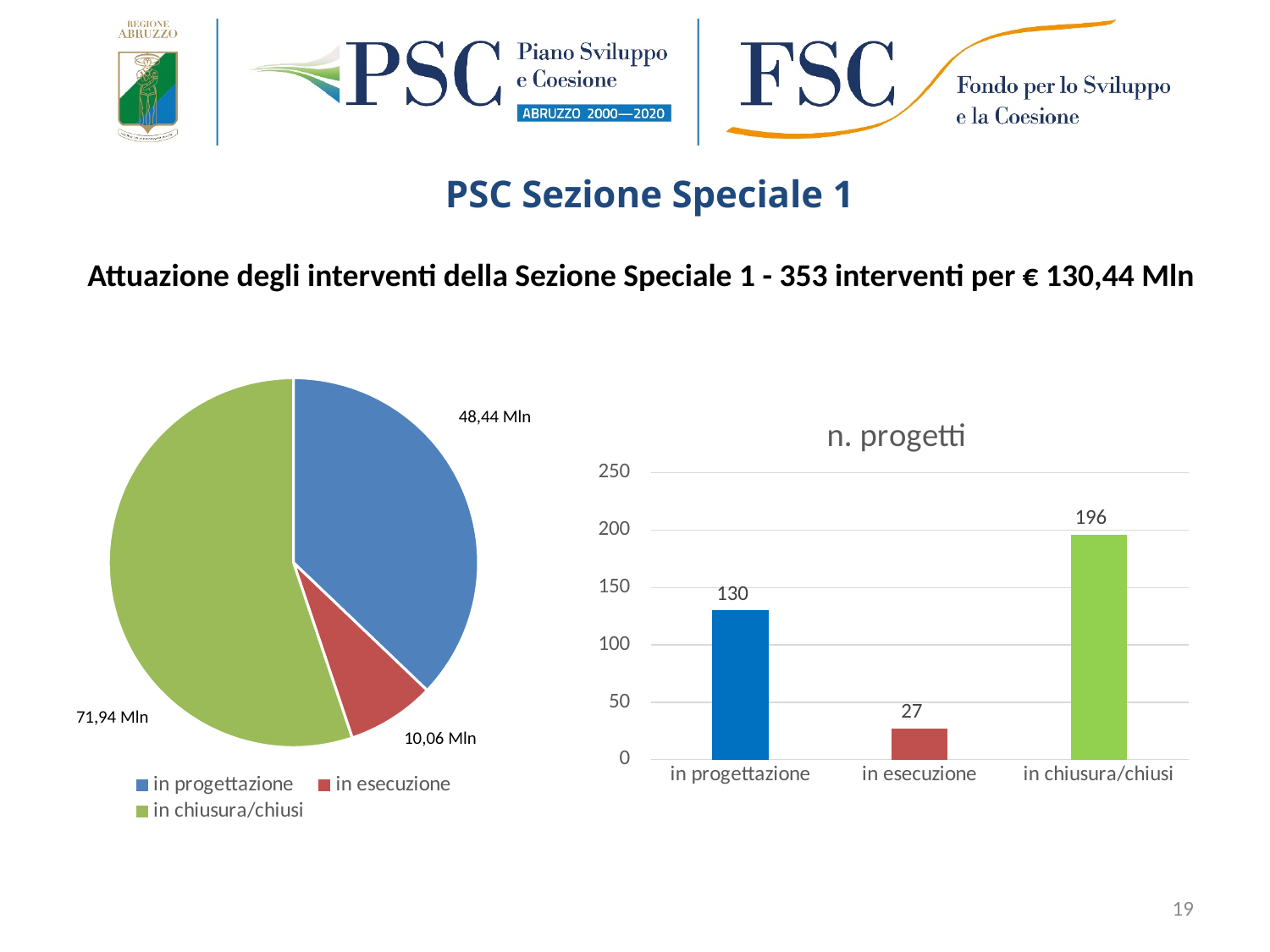
In the pie chart on the left, what is the value labelled for the "in esecuzione" slice? 10,06 Mln In the pie chart on the left, what is the value labelled for the "in progettazione" slice? 48,44 Mln In the bar chart titled "n. progetti", which category has the highest value? in chiusura/chiusi In the pie chart on the left, which category has the largest slice? in chiusura/chiusi In the bar chart titled "n. progetti", what is the value for "in chiusura/chiusi"? 196 In the pie chart on the left, how many entries does the legend list? 3 In the bar chart titled "n. progetti", what is the value for "in esecuzione"? 27 In the bar chart titled "n. progetti", which category has the lowest value? in esecuzione In the bar chart titled "n. progetti", what is the difference between the values for "in chiusura/chiusi" and "in progettazione"? 66 In the bar chart titled "n. progetti", how many categories are shown on the x axis? 3 In the pie chart on the left, what is the difference between the values for "in chiusura/chiusi" and "in progettazione"? 23,50 Mln What kind of chart is the chart on the right of the slide? bar chart